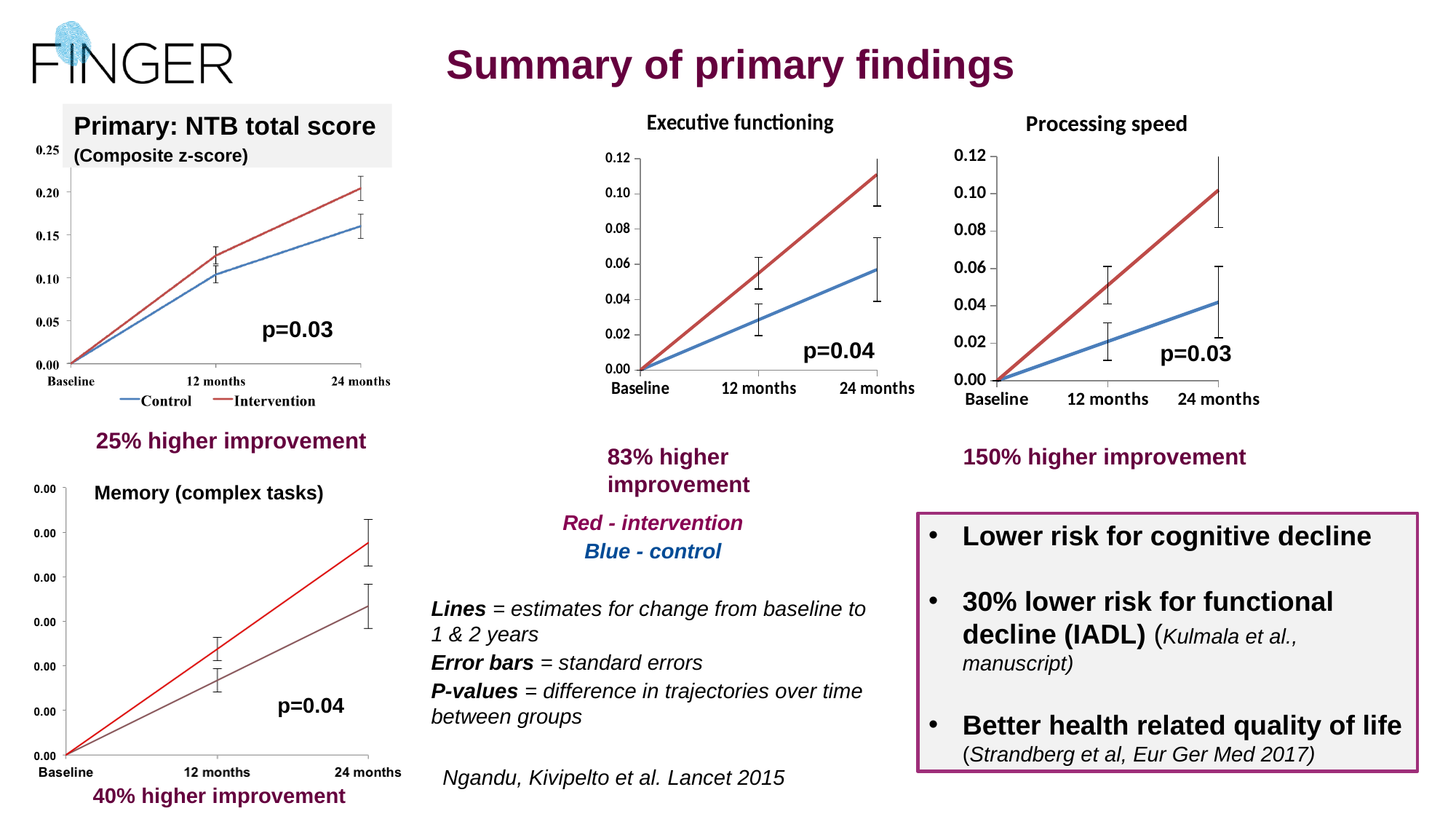
In the Memory (complex tasks) chart, do the values rise or fall from Baseline to 24 months? rise In the Processing speed chart, is the value for the intervention (red) line at 24 months greater or less than 0.08? greater In the Executive functioning chart, is the value for the control (blue) line at 24 months greater or less than 0.04? greater In the Primary: NTB total score chart, is the value for Control at 24 months greater or less than 0.15? greater What kind of chart is the Primary: NTB total score chart? line chart How many time points are plotted along the x axis of the Executive functioning chart? 3 In the Processing speed chart, which line is higher at 24 months, intervention (red) or control (blue)? intervention (red) How many series does the legend of the Primary: NTB total score chart list? 2 What p-value is printed on the Processing speed chart? p=0.03